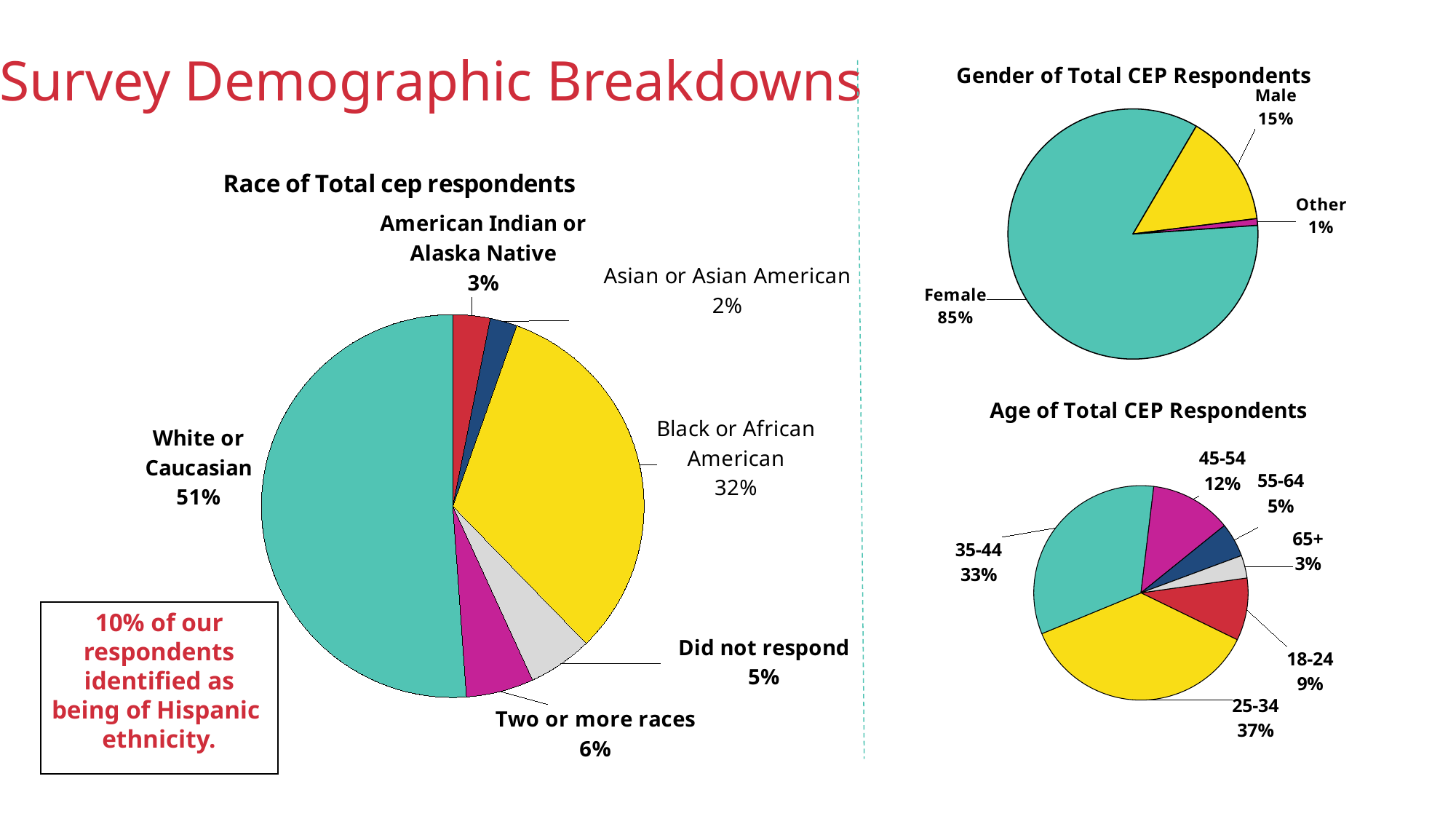
In the 'Age of Total CEP Respondents' chart, which is larger: the 45-54 share or the 18-24 share? 45-54 In the 'Gender of Total CEP Respondents' chart, which category has the smallest share? Other In the 'Age of Total CEP Respondents' chart, how many age groups are shown? 6 In the 'Race of Total cep respondents' chart, which category has the smallest share? Asian or Asian American In the 'Gender of Total CEP Respondents' chart, what share of respondents are Female? 85% In the 'Race of Total cep respondents' chart, what is the difference between the White or Caucasian share and the Black or African American share? 19% In the 'Race of Total cep respondents' chart, what share of respondents are Black or African American? 32% How many pie charts are on the slide? 3 In the 'Race of Total cep respondents' chart, which category has the largest share? White or Caucasian In the 'Age of Total CEP Respondents' chart, what share of respondents are aged 25-34? 37% What kind of chart is 'Age of Total CEP Respondents'? Pie chart In the 'Race of Total cep respondents' chart, how many categories are shown? 6